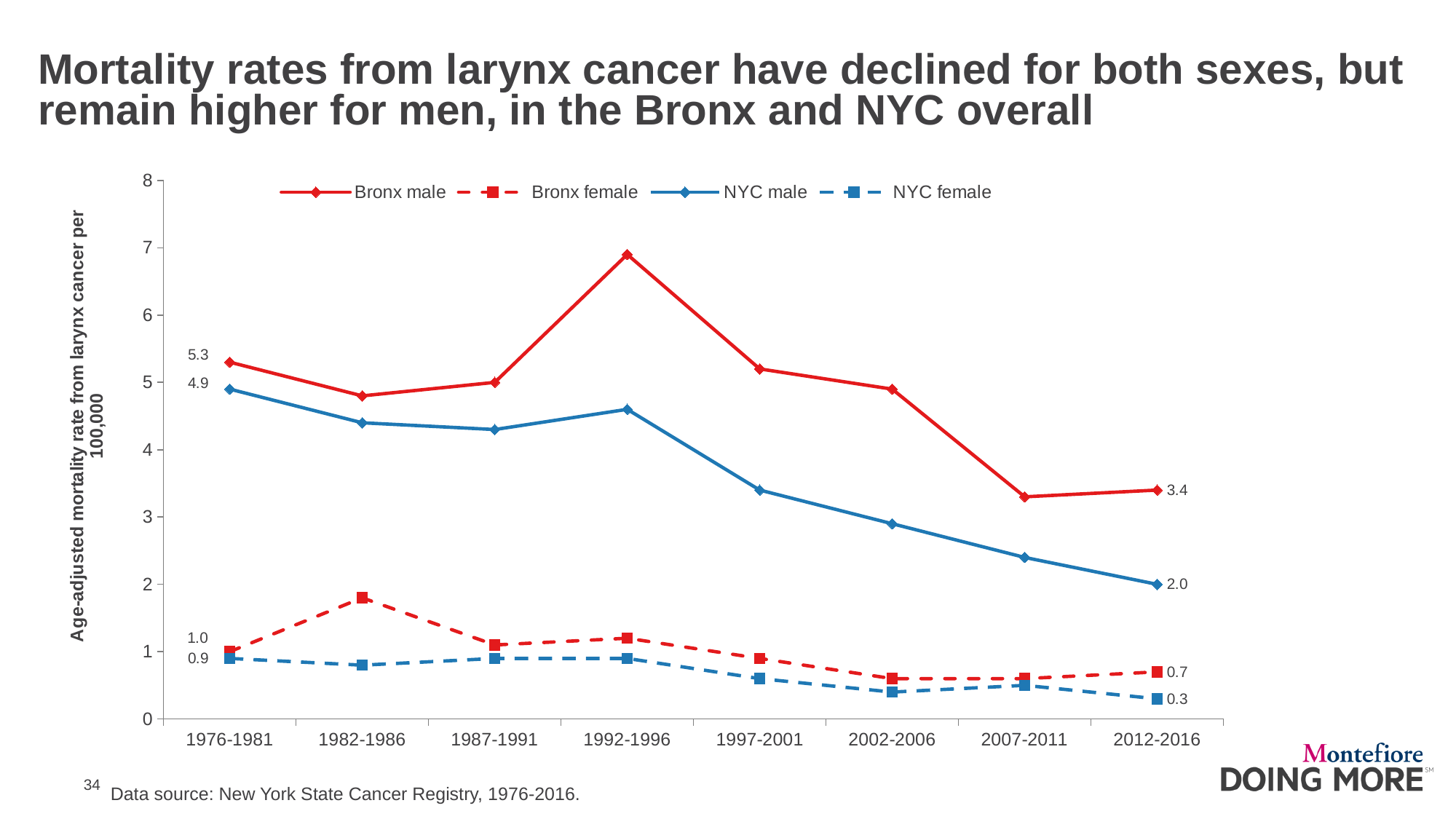
What is the Bronx female mortality rate for 1976-1981? 1.0 What type of chart is shown on the slide? line chart By how much did the Bronx male mortality rate fall from 1976-1981 to 2012-2016? 1.9 What is the difference between the Bronx male and NYC male rates in 1976-1981? 0.4 How many time periods are shown on the x axis? 8 In which period does the Bronx male series reach its highest value? 1992-1996 Does the NYC male series rise or fall from 1992-1996 to 2012-2016? fall What is the NYC female mortality rate for 2012-2016? 0.3 How many series does the legend list? 4 What is the NYC male mortality rate for 2012-2016? 2.0 Is the Bronx male value for 1992-1996 greater or less than 6? greater What is the Bronx male mortality rate for 1976-1981? 5.3